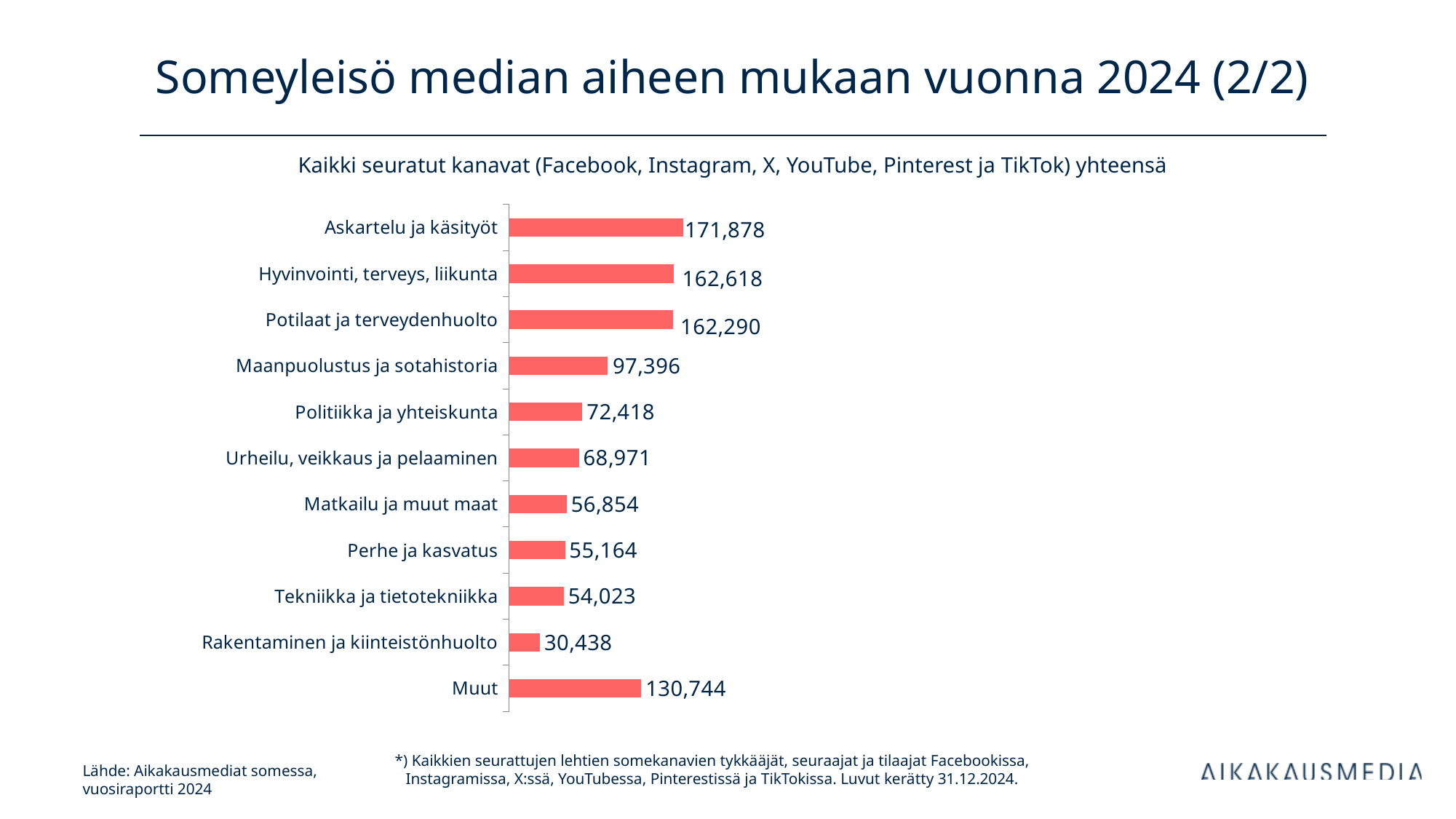
What is the value for Askartelu ja käsityöt? 171,878 What is the value for Tekniikka ja tietotekniikka? 54,023 Which category has the lowest value? Rakentaminen ja kiinteistönhuolto How many categories are shown in the chart? 11 Which is larger, the value for Muut or the value for Maanpuolustus ja sotahistoria? Muut Which category has the highest value? Askartelu ja käsityöt What is the difference between the values for Askartelu ja käsityöt and Rakentaminen ja kiinteistönhuolto? 141,440 What is the value for Muut? 130,744 What is the difference between the values for Maanpuolustus ja sotahistoria and Politiikka ja yhteiskunta? 24,978 What kind of chart is shown on the slide? Bar chart What is the value for Politiikka ja yhteiskunta? 72,418 What is the title of the chart? Kaikki seuratut kanavat (Facebook, Instagram, X, YouTube, Pinterest ja TikTok) yhteensä